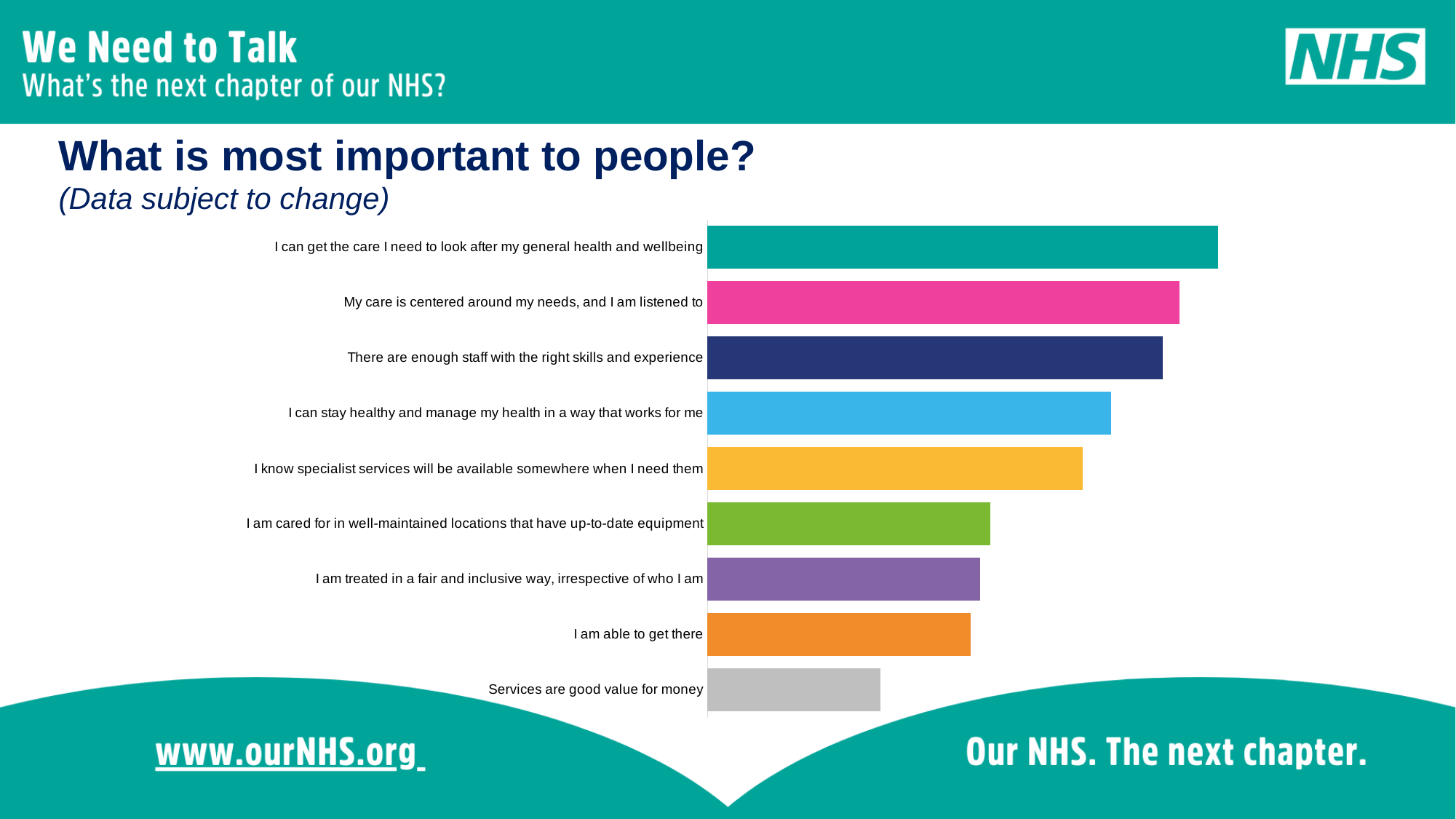
Which category has the shortest bar in the chart? Services are good value for money Which has the larger value: 'There are enough staff with the right skills and experience' or 'I know specialist services will be available somewhere when I need them'? There are enough staff with the right skills and experience What kind of chart is shown on the slide? Bar chart What colour is the bar for 'Services are good value for money'? Grey Which has the larger value: 'Services are good value for money' or 'I am able to get there'? I am able to get there Do the bar lengths increase or decrease going from the top category to the bottom category? Decrease How many categories (bars) does the chart show? 9 Which category is second from the top in the chart? My care is centered around my needs, and I am listened to Which category has the longest bar in the chart? I can get the care I need to look after my general health and wellbeing Which has the larger value: 'I am cared for in well-maintained locations that have up-to-date equipment' or 'I can stay healthy and manage my health in a way that works for me'? I can stay healthy and manage my health in a way that works for me